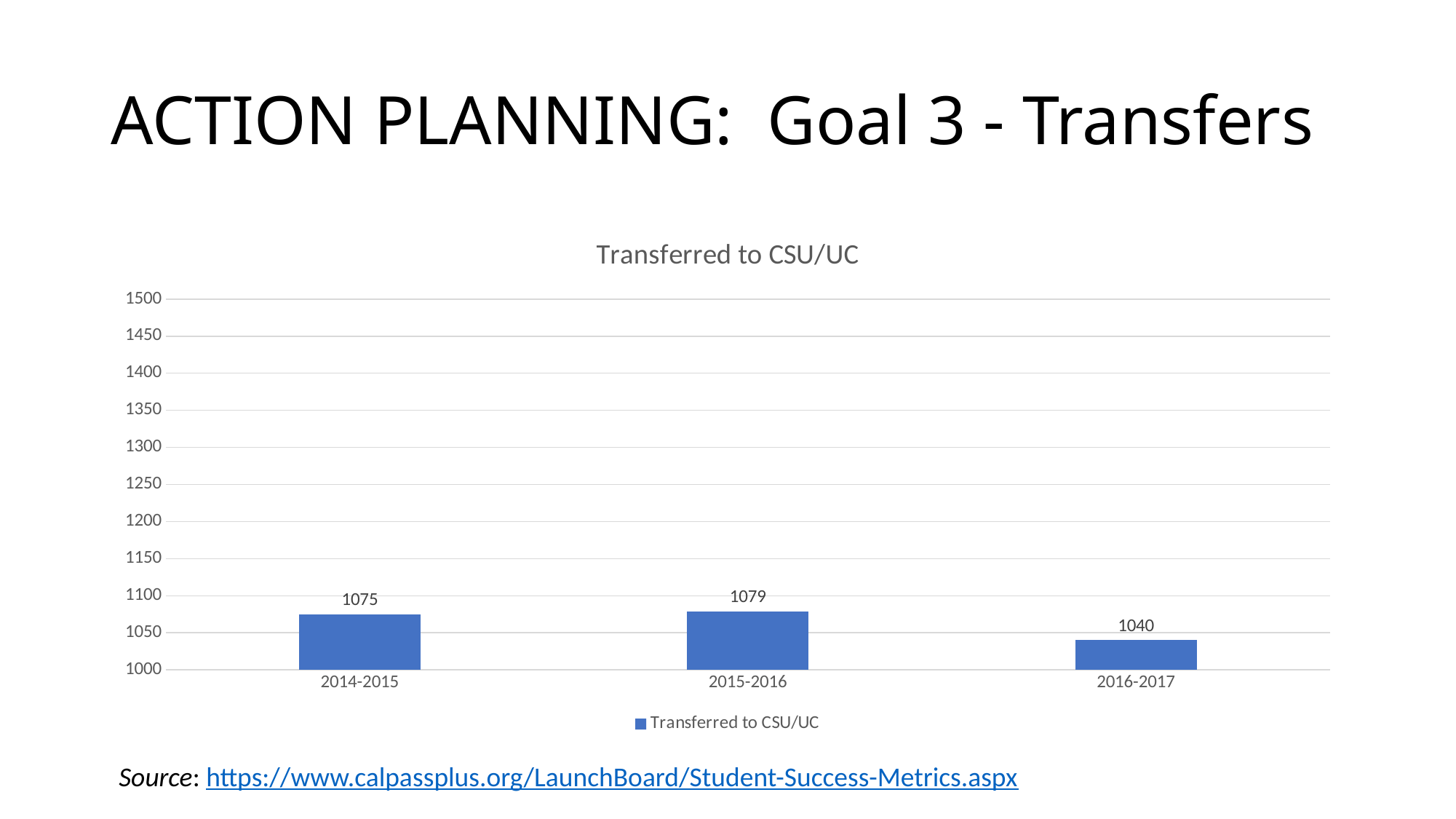
What is the value for 2015-2016? 1079 Which year has the lowest number transferred to CSU/UC? 2016-2017 What is the value for 2016-2017? 1040 What is the title of the chart? Transferred to CSU/UC How many years are shown on the x axis? 3 How many series does the legend list? 1 Is the value for 2016-2017 greater or less than 1050? less What is the value for 2014-2015? 1075 What kind of chart is shown on the slide? bar chart What is the difference between the values for 2014-2015 and 2016-2017? 35 What is the difference between the values for 2015-2016 and 2016-2017? 39 Which is larger, the value for 2014-2015 or the value for 2016-2017? 2014-2015